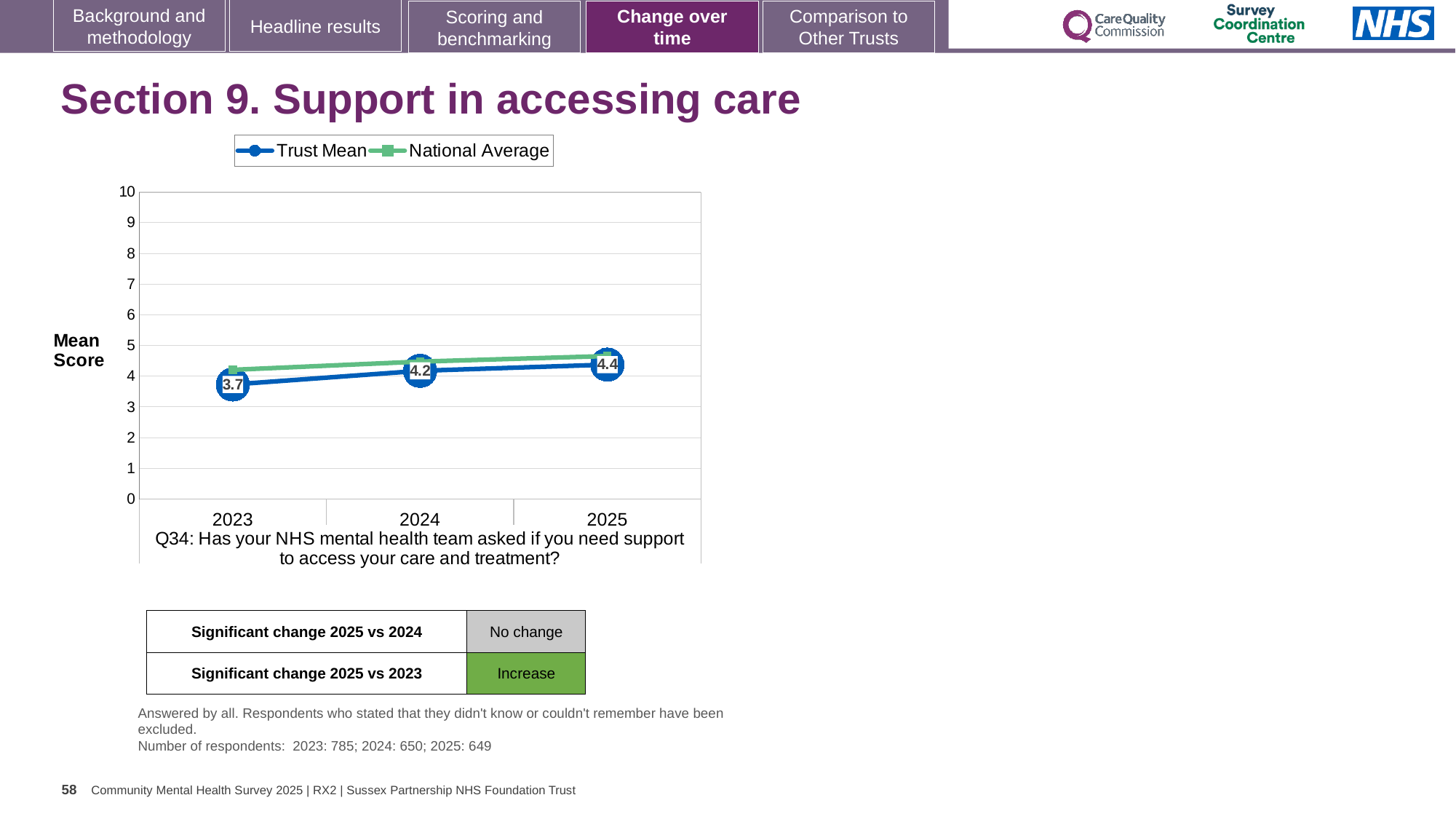
Is the National Average value for 2025 greater or less than 5? less How many series does the chart legend list? 2 What is the Trust Mean score for 2024? 4.2 Does the Trust Mean score rise or fall from 2023 to 2025? Rise What is the Trust Mean score for 2025? 4.4 What type of chart is shown on the slide? Line chart How many years are shown on the x axis of the chart? 3 What is the Trust Mean score for 2023? 3.7 What is the difference between the Trust Mean score in 2025 and in 2023? 0.7 In 2023, which is higher: the Trust Mean or the National Average? National Average In which year is the Trust Mean score highest? 2025 In which year is the Trust Mean score lowest? 2023